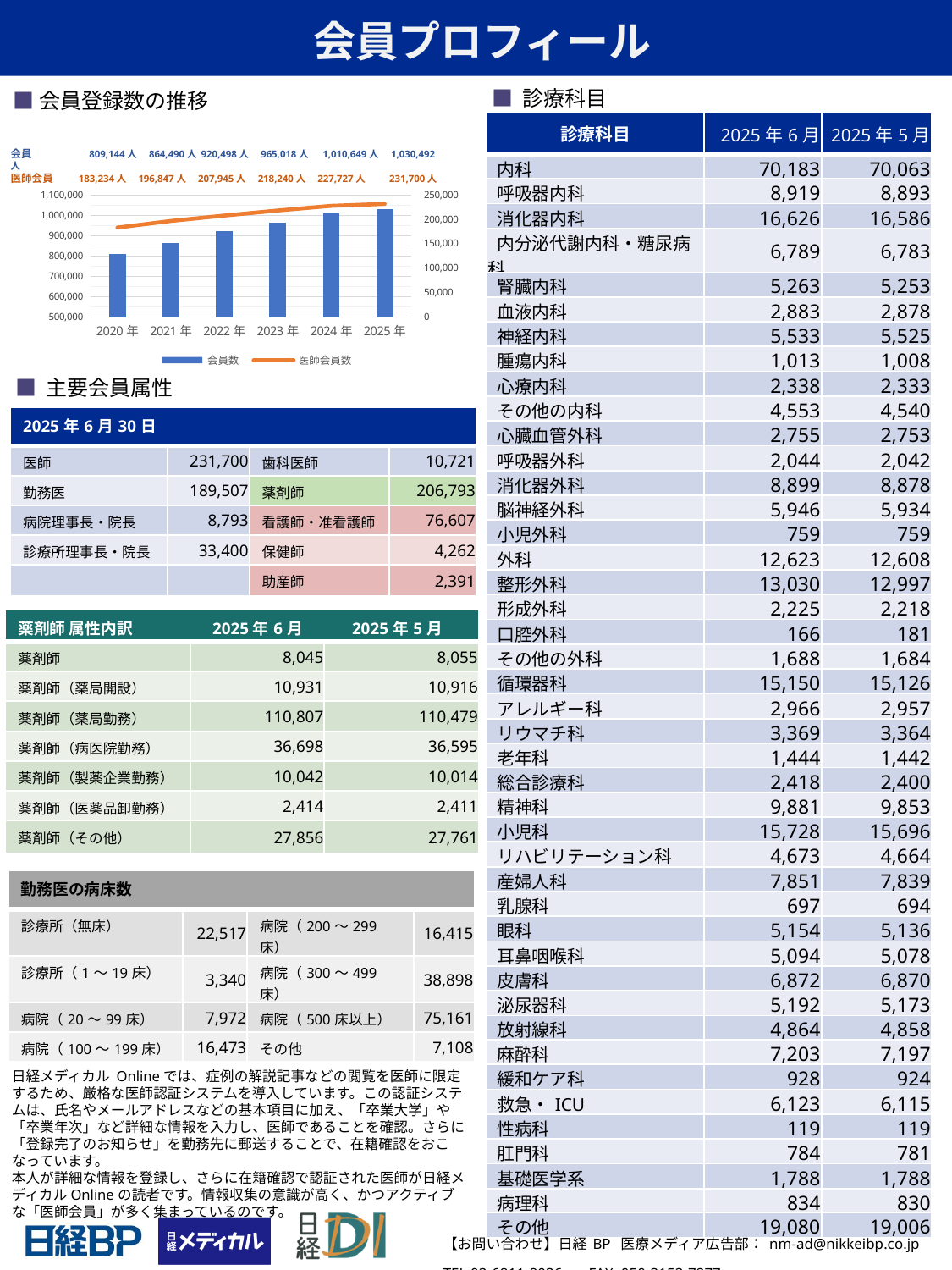
In the 会員登録数の推移 chart, what is the 医師会員 value for 2025年? 231,700人 Do the 会員数 values in the 会員登録数の推移 chart rise or fall from 2020年 to 2025年? rise How many years are shown on the x axis of the 会員登録数の推移 chart? 6 In the 会員登録数の推移 chart, is the 会員 value for 2022年 larger or smaller than the value for 2021年? larger In the 会員登録数の推移 chart, which year has the lowest 医師会員数? 2020年 In the 会員登録数の推移 chart, what is the 会員 value for 2023年? 965,018人 How many series does the legend of the 会員登録数の推移 chart list? 2 In the 会員登録数の推移 chart, what is the 医師会員 value for 2022年? 207,945人 In the 会員登録数の推移 chart, what is the difference between the 医師会員 values for 2025年 and 2020年? 48,466 In the 会員登録数の推移 chart, by how much did the 会員 value increase from 2024年 to 2025年? 19,843 In the 会員登録数の推移 chart, what is the 会員 value for 2020年? 809,144人 In the 会員登録数の推移 chart, which year has the highest 会員数? 2025年